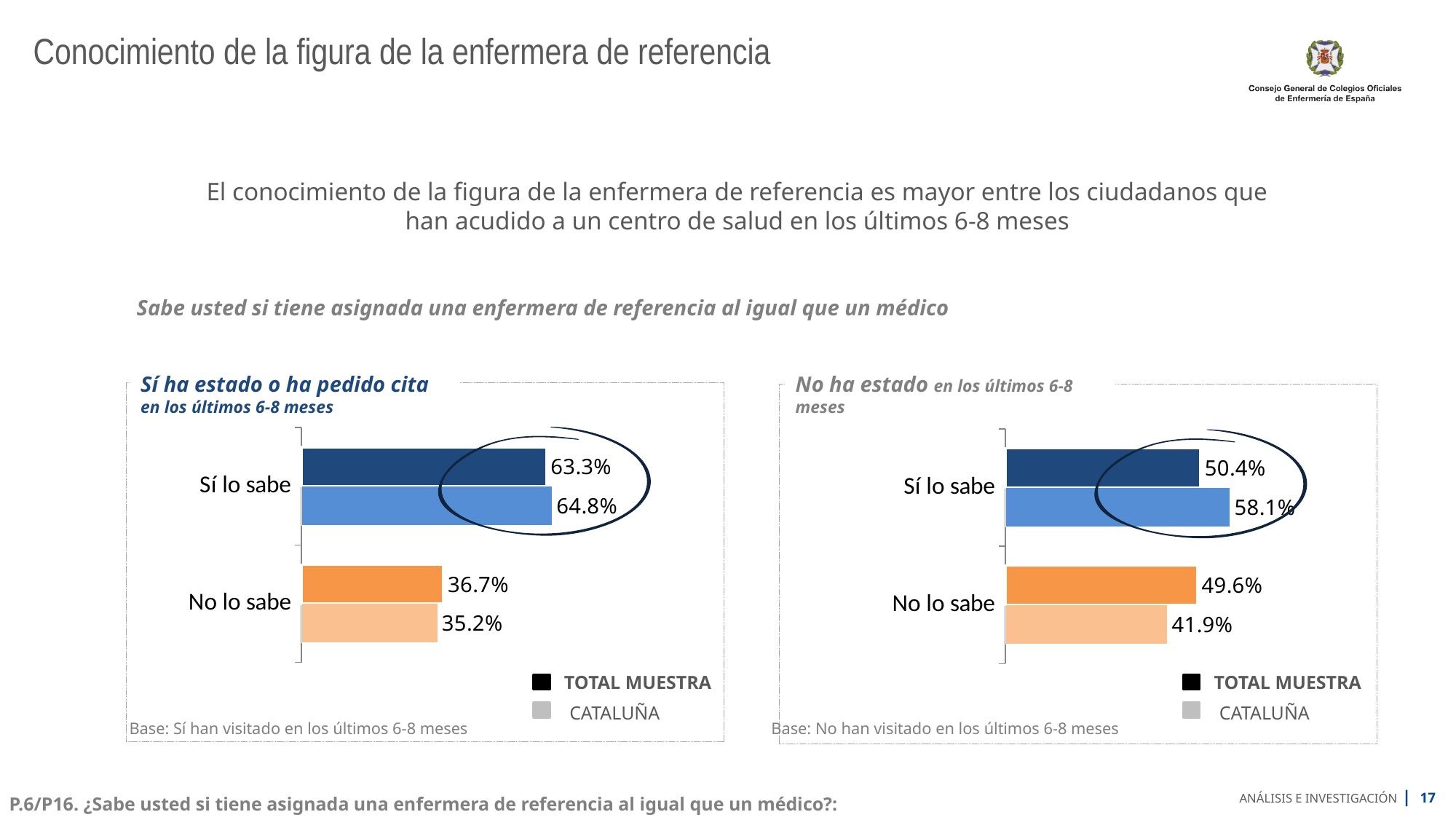
In the chart titled 'Sí ha estado o ha pedido cita en los últimos 6-8 meses', what is the value for 'Sí lo sabe' for the TOTAL MUESTRA series? 63.3% In the chart titled 'No ha estado en los últimos 6-8 meses', what is the value for 'Sí lo sabe' for the CATALUÑA series? 58.1% In the chart titled 'No ha estado en los últimos 6-8 meses', which is larger for the CATALUÑA series: 'Sí lo sabe' or 'No lo sabe'? Sí lo sabe How many series does the legend list in the chart titled 'Sí ha estado o ha pedido cita en los últimos 6-8 meses'? 2 In the chart titled 'No ha estado en los últimos 6-8 meses', what is the value for 'No lo sabe' for the TOTAL MUESTRA series? 49.6% In the chart titled 'No ha estado en los últimos 6-8 meses', which category has the lowest value across both series? No lo sabe (CATALUÑA, 41.9%) What kind of chart is the chart titled 'No ha estado en los últimos 6-8 meses'? Bar chart In the chart titled 'Sí ha estado o ha pedido cita en los últimos 6-8 meses', what is the value for 'Sí lo sabe' for the CATALUÑA series? 64.8% In the chart titled 'No ha estado en los últimos 6-8 meses', what is the difference between the TOTAL MUESTRA and CATALUÑA values for 'Sí lo sabe'? 7.7% How many categories are shown on the y axis of the chart titled 'Sí ha estado o ha pedido cita en los últimos 6-8 meses'? 2 In the chart titled 'Sí ha estado o ha pedido cita en los últimos 6-8 meses', what is the value for 'No lo sabe' for the CATALUÑA series? 35.2% In the chart titled 'Sí ha estado o ha pedido cita en los últimos 6-8 meses', what is the difference between the TOTAL MUESTRA values for 'Sí lo sabe' and 'No lo sabe'? 26.6%